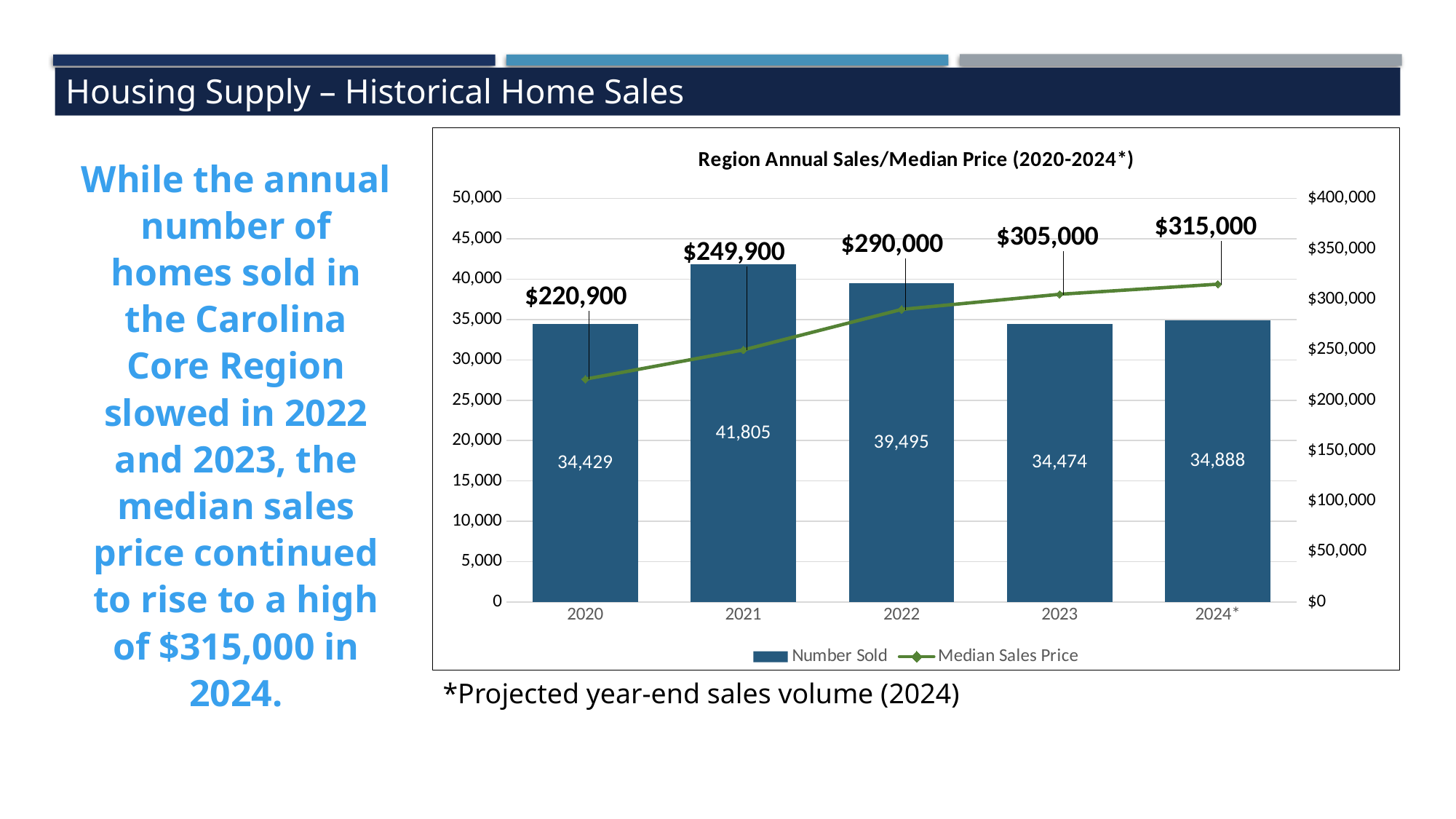
How many years are shown on the x axis? 5 What is the difference in Median Sales Price between 2024* and 2020? $94,100 Does the Median Sales Price rise or fall from 2020 to 2024*? rise What is the Number Sold value for 2024*? 34,888 What is the title of the chart? Region Annual Sales/Median Price (2020-2024*) What is the Median Sales Price for 2022? $290,000 Which year has the lowest Median Sales Price? 2020 How many series does the legend list? 2 Which year has the highest Number Sold? 2021 What is the Number Sold value for 2021? 41,805 Which year had more homes sold, 2022 or 2023? 2022 What is the difference in Number Sold between 2021 and 2022? 2,310